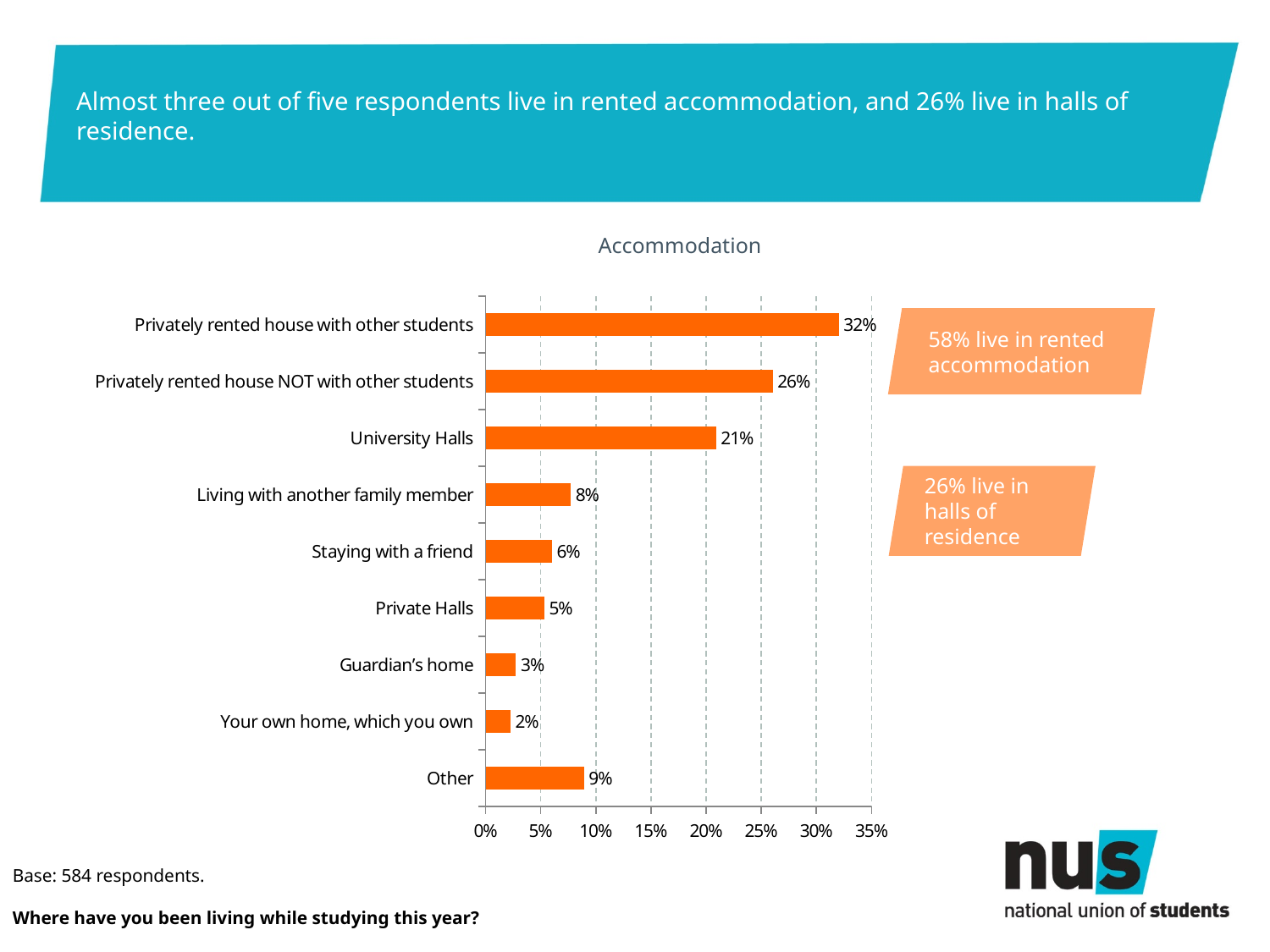
What percentage of respondents are staying with a friend? 6% What kind of chart is shown on the slide? Bar chart What is the value for Private Halls? 5% Which accommodation category has the lowest value? Your own home, which you own What is the total of the values for University Halls and Private Halls? 26% What percentage of respondents live in a privately rented house with other students? 32% What is the title of the chart? Accommodation Which is larger, the value for Other or the value for Living with another family member? Other What is the value for University Halls? 21% How many accommodation categories are shown in the chart? 9 Which accommodation category has the highest value? Privately rented house with other students What is the difference between the values for Privately rented house with other students and Privately rented house NOT with other students? 6%